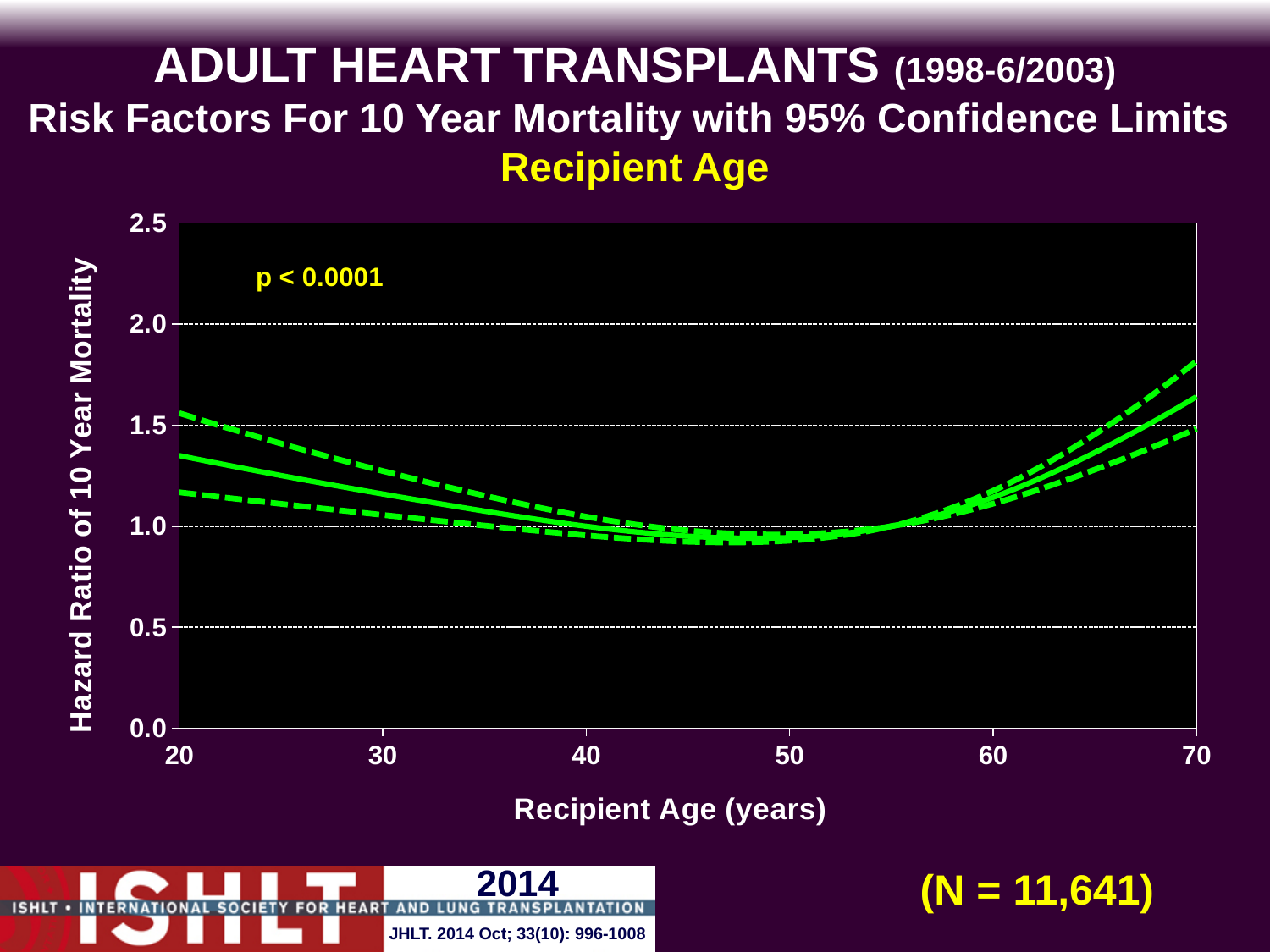
How many lines (solid and dashed) are plotted on the chart? 3 Is the hazard ratio on the solid line at recipient age 20 greater or less than 1.5? less Which recipient age has the lower hazard ratio on the solid line, 30 or 50? 50 Does the solid hazard ratio line rise or fall as recipient age increases from 55 to 70 years? rise What is the label of the x axis? Recipient Age (years) Is the hazard ratio on the solid line at recipient age 20 greater or less than 1.0? greater Which recipient age has the higher hazard ratio on the solid line, 20 or 70? 70 Is the hazard ratio on the solid line at recipient age 50 greater or less than 1.5? less Does the solid hazard ratio line rise or fall as recipient age increases from 20 to 45 years? fall What kind of chart is shown on the slide? line chart What is the label of the y axis? Hazard Ratio of 10 Year Mortality